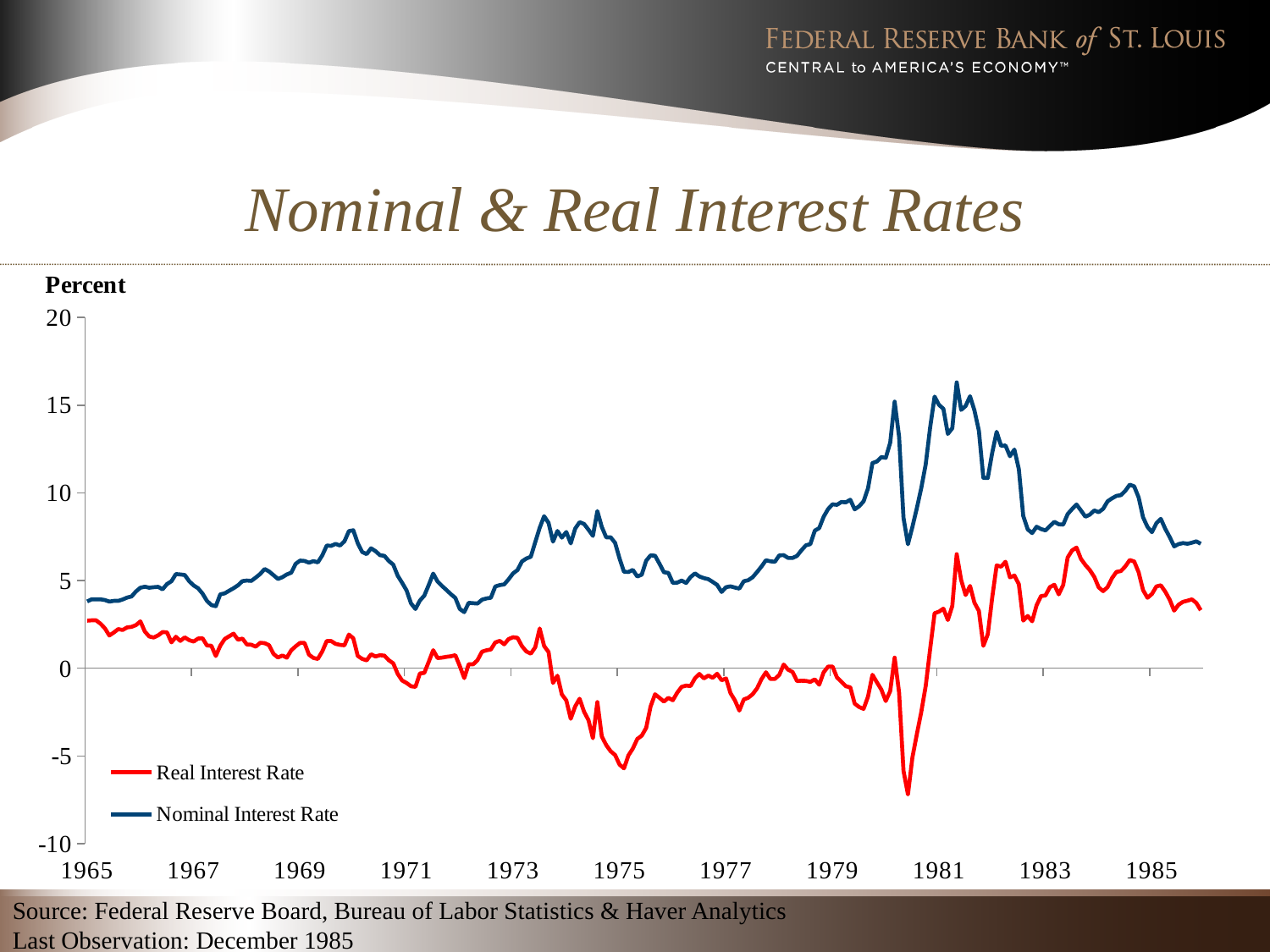
What kind of chart is shown on the slide? Line chart How many series does the legend list? 2 Does the Nominal Interest Rate rise or fall between 1977 and 1981? Rise Which series is higher in 1981, the Real Interest Rate or the Nominal Interest Rate? Nominal Interest Rate Which series reaches the highest value on the chart? Nominal Interest Rate Is the Real Interest Rate in 1965 greater or less than 0? greater Is the Nominal Interest Rate at the end of 1985 greater or less than 10? less Is the lowest point of the Real Interest Rate around 1980 greater or less than -5? less Which series is drawn in red? Real Interest Rate What is the title of the chart? Nominal & Real Interest Rates